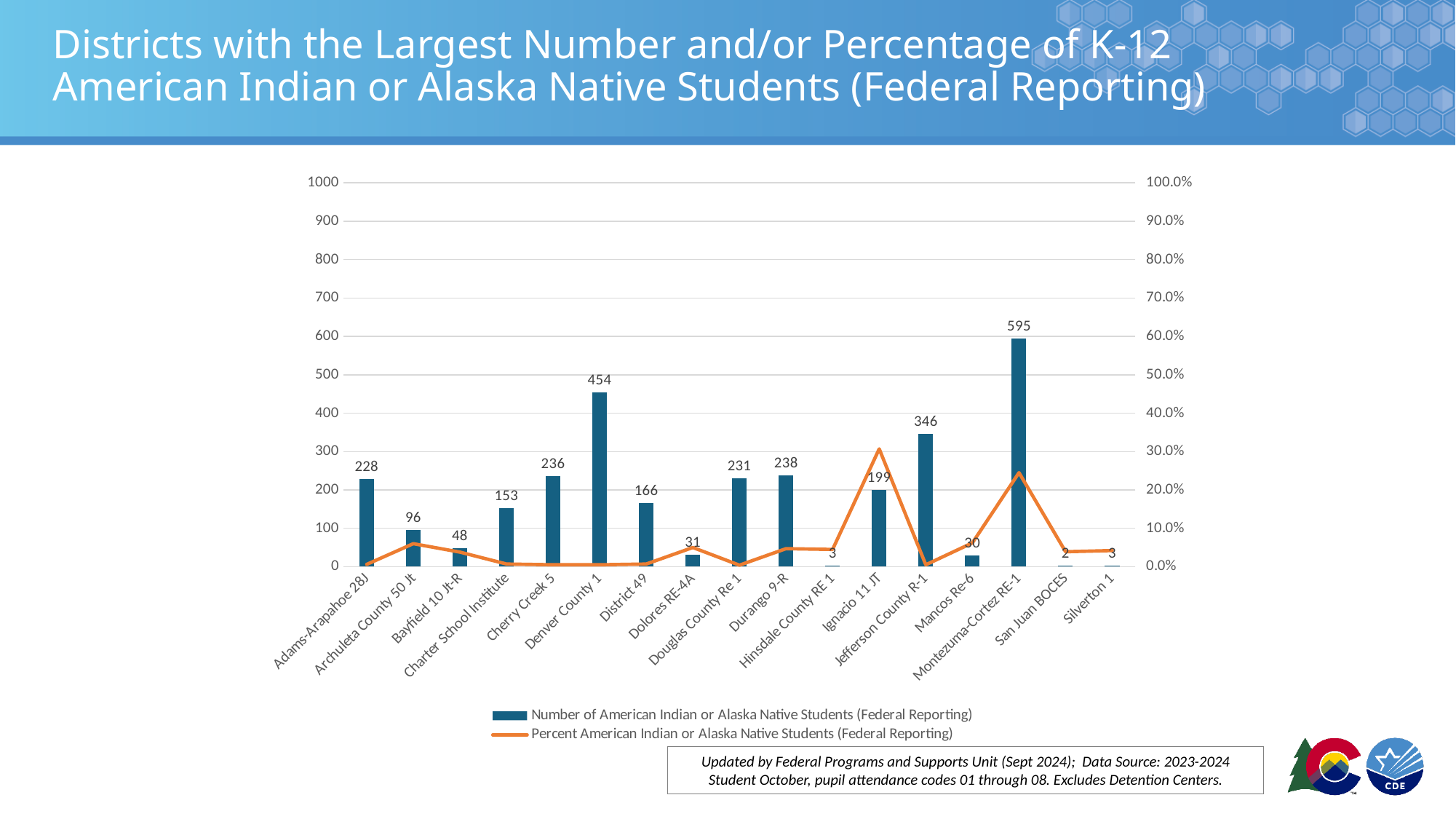
Which district has the lowest number of American Indian or Alaska Native students? San Juan BOCES What is the difference in the number of American Indian or Alaska Native students between Montezuma-Cortez RE-1 and Denver County 1? 141 What is the number of American Indian or Alaska Native students for Ignacio 11 JT? 199 Which has more American Indian or Alaska Native students, Denver County 1 or Jefferson County R-1? Denver County 1 What is the number of American Indian or Alaska Native students for Charter School Institute? 153 Is the percent of American Indian or Alaska Native students for Montezuma-Cortez RE-1 greater or less than 10.0%? greater What colour is the line showing the percent of American Indian or Alaska Native students? Orange What is the number of American Indian or Alaska Native students for Denver County 1? 454 How many districts are shown on the x axis of the chart? 17 Is the percent of American Indian or Alaska Native students for Ignacio 11 JT greater or less than 20.0%? greater Which district has the highest number of American Indian or Alaska Native students? Montezuma-Cortez RE-1 How many series does the chart legend list? 2